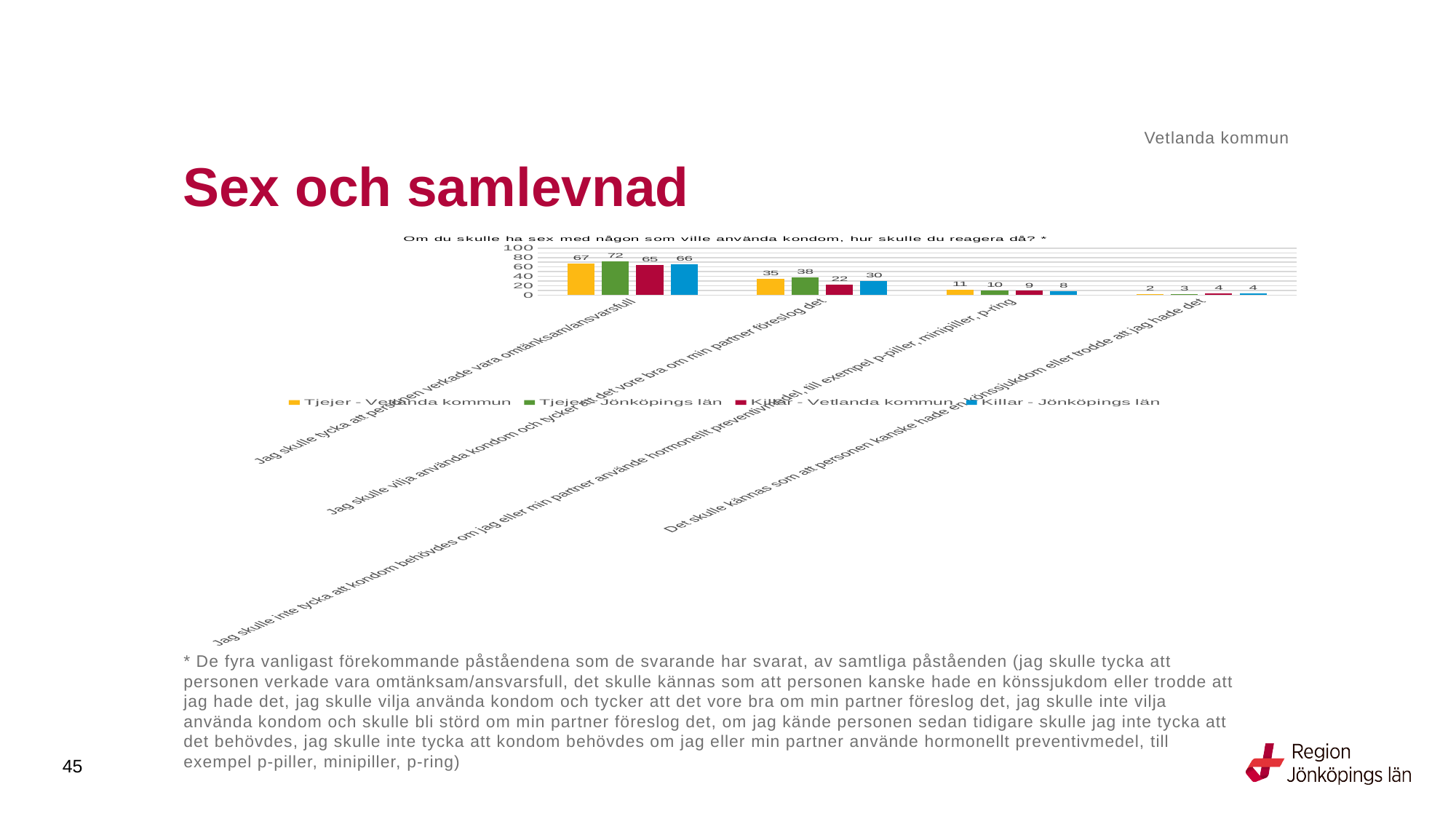
How many series does the legend list? 4 What is the value for Tjejer - Vetlanda kommun for the statement 'Jag skulle inte tycka att kondom behövdes om jag eller min partner använde hormonellt preventivmedel'? 11 What is the value for Tjejer - Jönköpings län for the statement 'Jag skulle tycka att personen verkade vara omtänksam/ansvarsfull'? 72 Which series has the highest value for the statement 'Jag skulle tycka att personen verkade vara omtänksam/ansvarsfull'? Tjejer - Jönköpings län Is the value for Killar - Jönköpings län for the statement 'Jag skulle tycka att personen verkade vara omtänksam/ansvarsfull' greater or less than 60? greater Which is larger for the statement 'Jag skulle vilja använda kondom och tycker att det vore bra om min partner föreslog det': Tjejer - Vetlanda kommun or Killar - Jönköpings län? Tjejer - Vetlanda kommun Which series has the lowest value for the statement 'Det skulle kännas som att personen kanske hade en könssjukdom eller trodde att jag hade det'? Tjejer - Vetlanda kommun What is the value for Killar - Vetlanda kommun for the statement 'Jag skulle vilja använda kondom och tycker att det vore bra om min partner föreslog det'? 22 What type of chart is shown on the slide? bar chart What is the difference between Tjejer - Jönköpings län and Killar - Vetlanda kommun for the statement 'Jag skulle vilja använda kondom och tycker att det vore bra om min partner föreslog det'? 16 How many categories (statements) are shown on the x axis? 4 What colour represents Killar - Vetlanda kommun in the legend? red